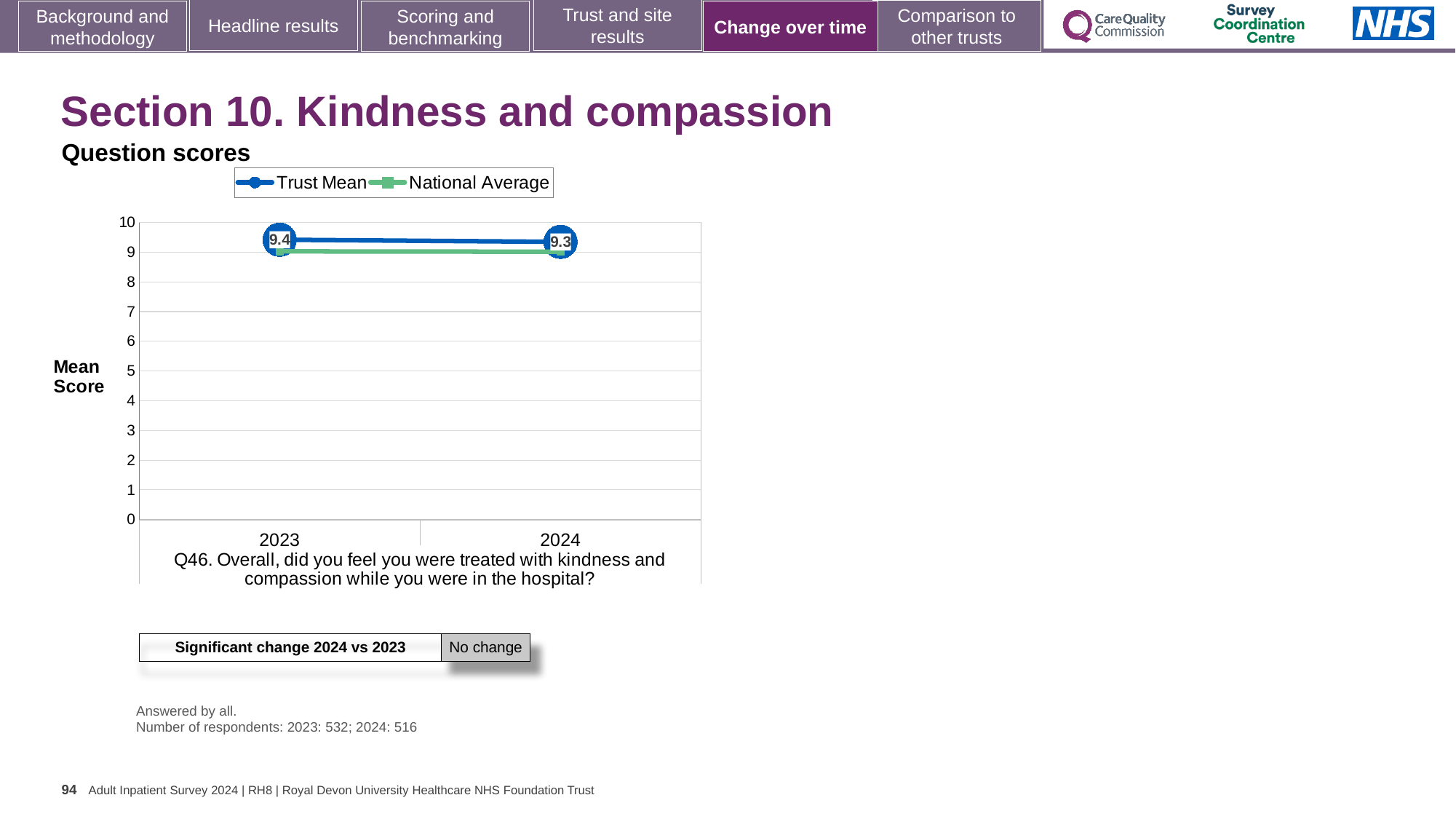
How many years are shown on the x axis of the chart? 2 What is the label on the y axis of the chart? Mean Score What type of chart is shown on the slide? Line chart Which year has the higher Trust Mean score, 2023 or 2024? 2023 Is the National Average value for 2024 greater or less than 8? greater Does the Trust Mean rise or fall from 2023 to 2024? Fall Is the National Average value for 2023 greater or less than 5? greater What is the Trust Mean score for 2023? 9.4 What is the difference between the Trust Mean scores for 2023 and 2024? 0.1 How many series does the chart legend list? 2 In 2023, which is higher, the Trust Mean or the National Average? Trust Mean What is the Trust Mean score for 2024? 9.3